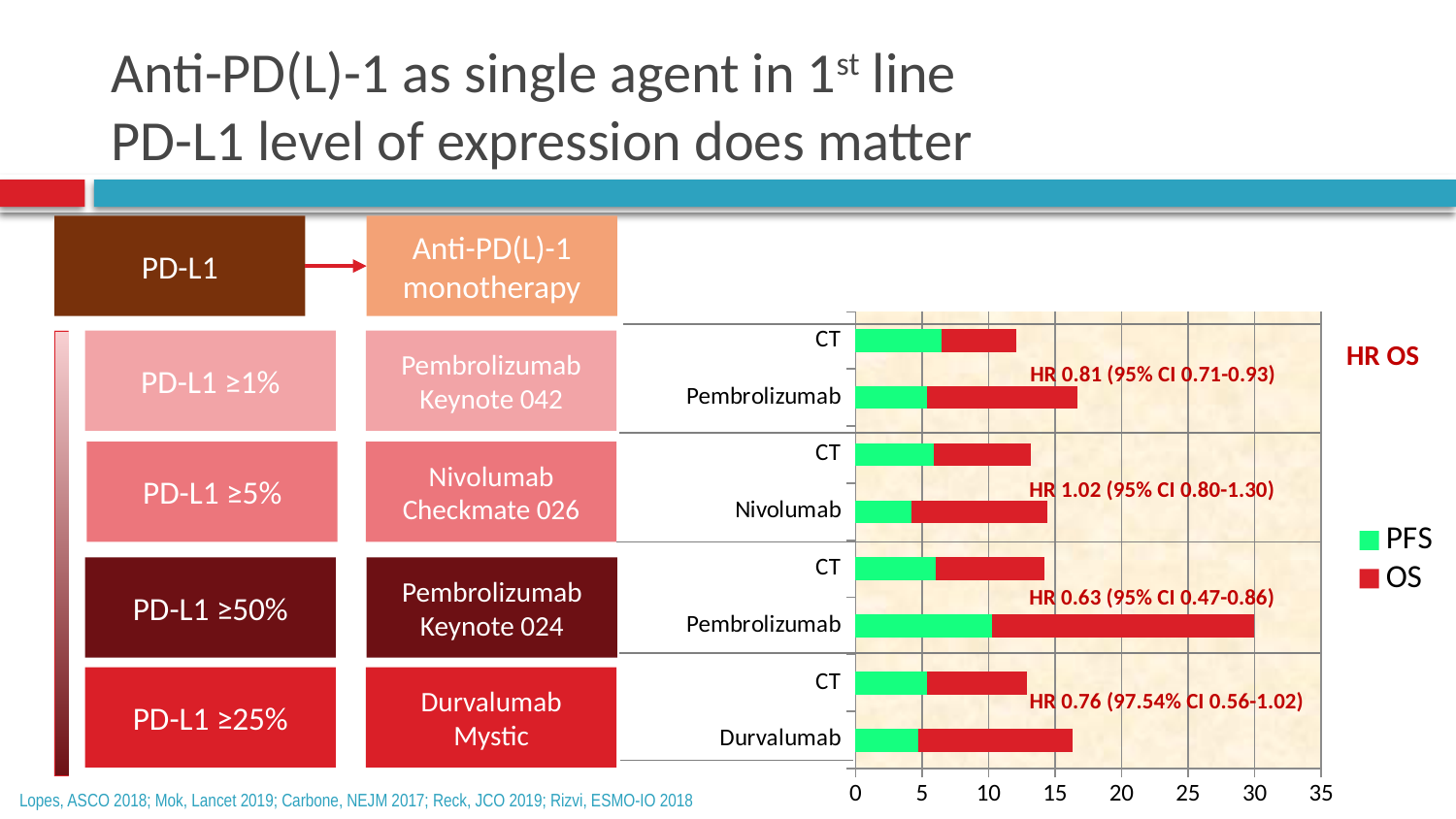
What are the two series named in the chart legend? PFS and OS Which colour represents OS in the chart? red Is the total length of the CT bar in the first group (above Pembrolizumab, Keynote 042) greater or less than 10? greater Is the total length of the Durvalumab bar greater or less than 15? greater Which has the longer green PFS segment: the Nivolumab bar or the Pembrolizumab bar in the third group (Keynote 024)? Pembrolizumab Is the total length of the Nivolumab bar greater or less than 20? less Which bar in the chart is the longest overall? Pembrolizumab (Keynote 024, third group) What kind of chart is shown on the right of the slide? bar chart How many series does the chart legend list? 2 How many bars are plotted in the chart? 8 Which is longer: the Pembrolizumab bar in the third group (Keynote 024) or the CT bar directly above it? Pembrolizumab